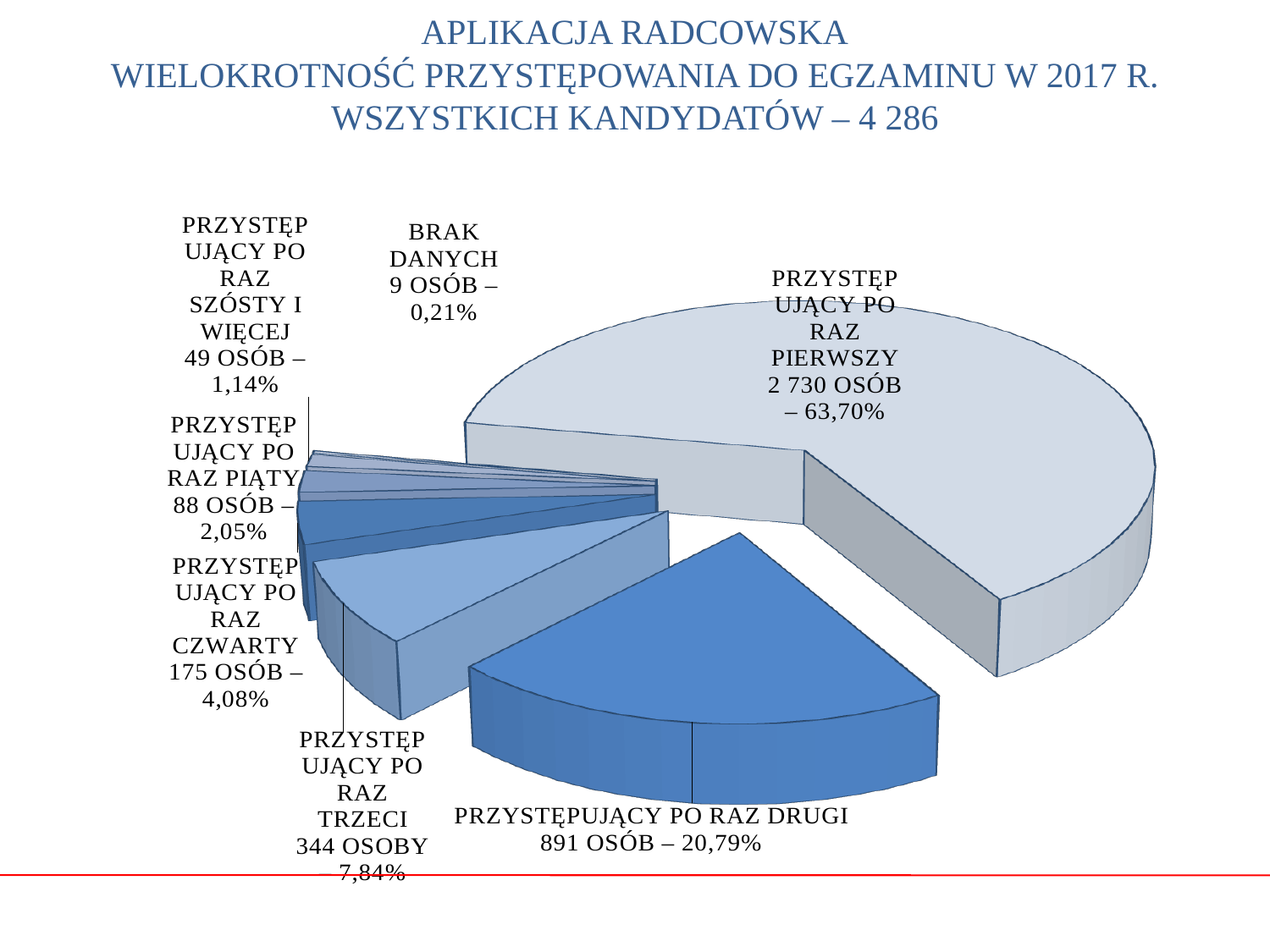
How many people are in the 'PRZYSTĘPUJĄCY PO RAZ PIERWSZY' slice? 2 730 OSÓB What percentage share does the 'PRZYSTĘPUJĄCY PO RAZ DRUGI' slice have? 20,79% What percentage share does the 'PRZYSTĘPUJĄCY PO RAZ CZWARTY' slice have? 4,08% How many people are in the 'PRZYSTĘPUJĄCY PO RAZ TRZECI' slice? 344 OSOBY What percentage share does the 'BRAK DANYCH' slice have? 0,21% What kind of chart is shown on the slide? pie chart How many slices does the pie chart have? 7 What is the total number of candidates stated in the chart title? 4 286 Which is larger: the 'PRZYSTĘPUJĄCY PO RAZ PIĄTY' slice or the 'PRZYSTĘPUJĄCY PO RAZ SZÓSTY I WIĘCEJ' slice? PRZYSTĘPUJĄCY PO RAZ PIĄTY What is the difference in number of people between 'PRZYSTĘPUJĄCY PO RAZ PIERWSZY' and 'PRZYSTĘPUJĄCY PO RAZ DRUGI'? 1 839 Which category has the largest slice of the pie? PRZYSTĘPUJĄCY PO RAZ PIERWSZY Which category has the smallest slice of the pie? BRAK DANYCH